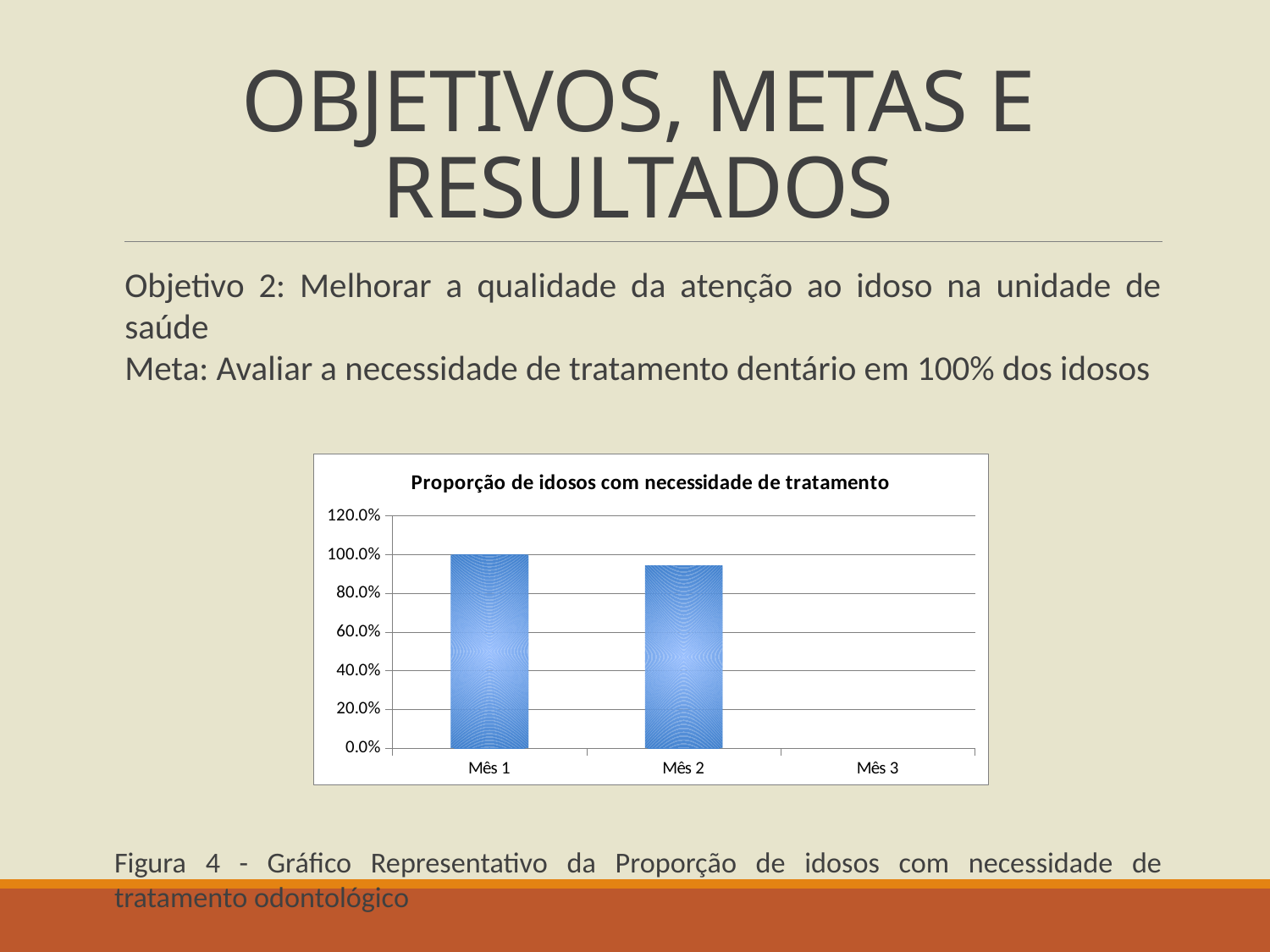
Which month has the highest value? Mês 1 Is the value for Mês 2 greater or less than 100.0%? less Is the value for Mês 2 greater or less than 80.0%? greater How many categories are shown on the x axis of the chart? 3 What is the highest value shown on the y axis of the chart? 120.0% What is the title of the chart? Proporção de idosos com necessidade de tratamento What is the value for Mês 1? 100.0% Which month has the lowest value? Mês 3 Which is larger, the value for Mês 1 or the value for Mês 2? Mês 1 Do the values rise or fall from Mês 1 to Mês 3? fall What kind of chart is shown on the slide? bar chart